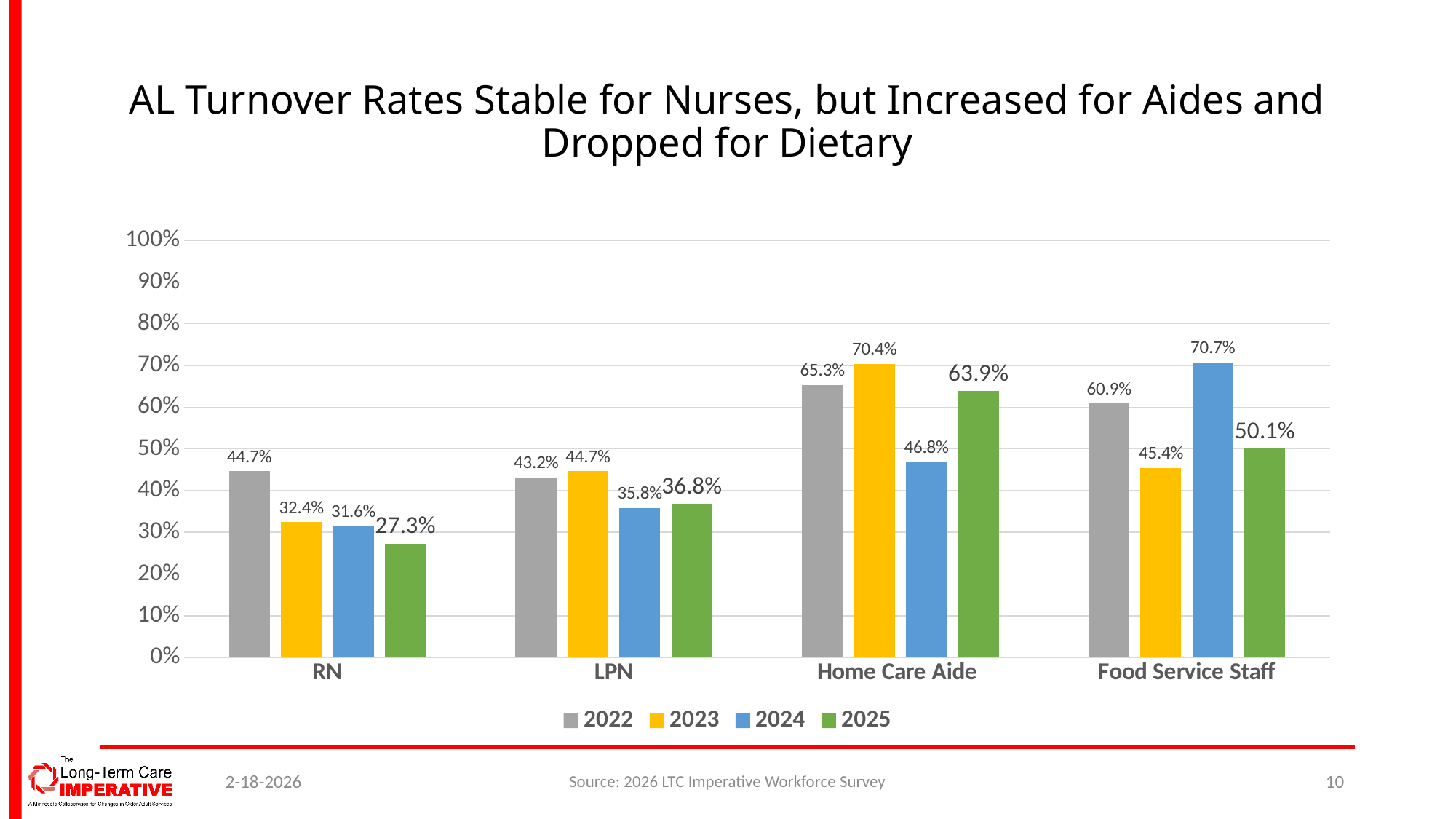
Which category has the highest 2025 turnover rate? Home Care Aide What is the 2022 turnover rate for LPN? 43.2% What is the difference between the 2024 and 2025 turnover rates for Food Service Staff? 20.6% What is the 2024 turnover rate for Food Service Staff? 70.7% What is the 2023 turnover rate for Home Care Aide? 70.4% How many series does the legend list? 4 Is the 2025 turnover rate for LPN greater or less than 40%? less How many job categories are shown on the x axis? 4 Which category has the lowest 2024 turnover rate? RN What is the 2025 turnover rate for RN? 27.3% What kind of chart is shown on the slide? bar chart Which is larger, the 2022 turnover rate for Home Care Aide or the 2022 turnover rate for Food Service Staff? Home Care Aide